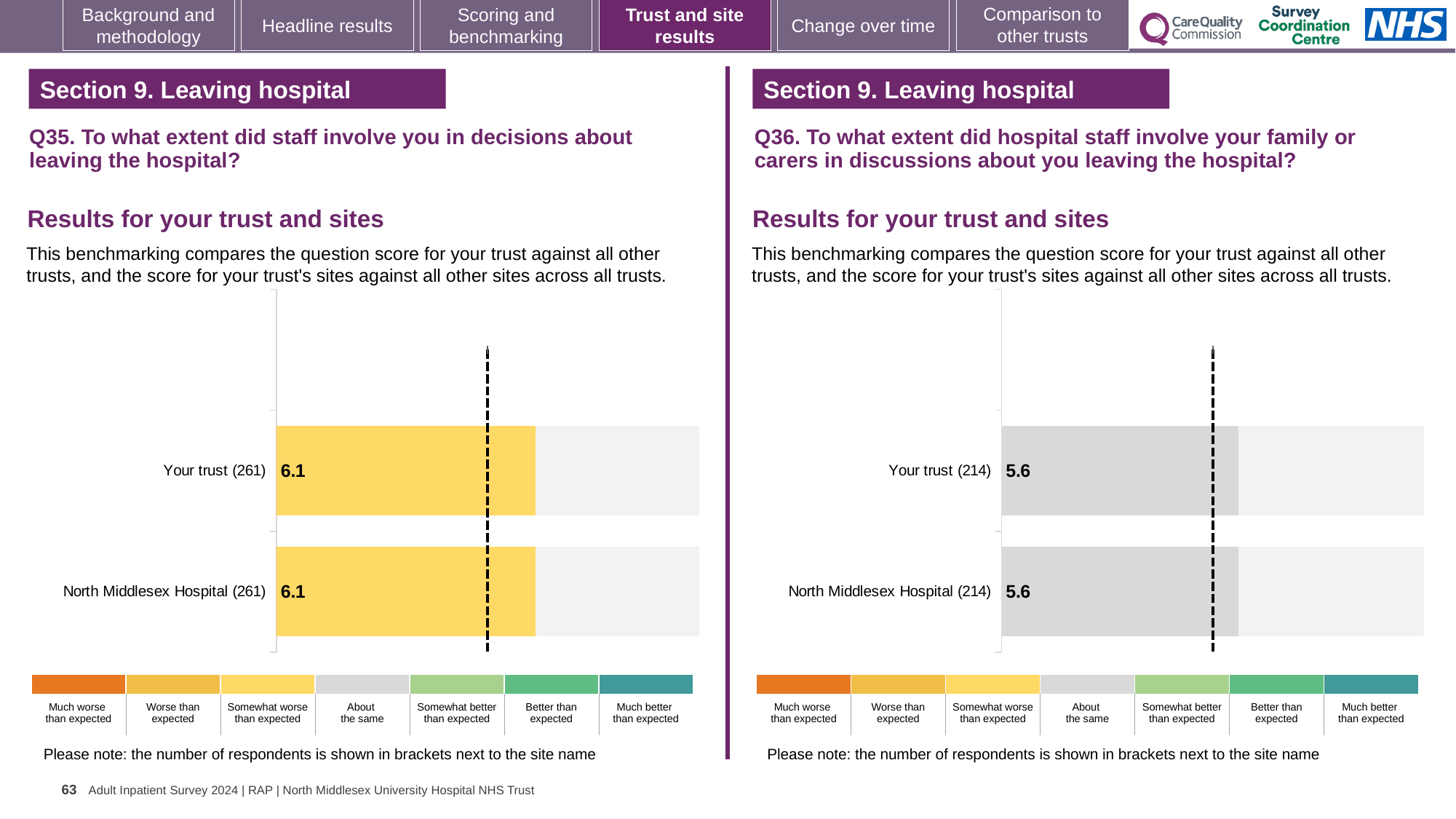
What kind of chart is used for the Q35 results on the left? Bar chart How many bars are plotted in the Q36 chart on the right? 2 In the Q36 chart on the right, what is the score for Your trust? 5.6 According to the colour key, which benchmark category do the grey bars in the Q36 chart on the right represent? About the same In the Q35 chart on the left, how many respondents are shown in brackets next to Your trust? 261 How many bars are plotted in the Q35 chart on the left? 2 In the Q35 chart on the left, what is the difference between the Your trust score and the North Middlesex Hospital score? 0 In the Q35 chart on the left, what is the score for North Middlesex Hospital? 6.1 In the Q36 chart on the right, what is the score for North Middlesex Hospital? 5.6 In the Q36 chart on the right, how many respondents are shown in brackets next to North Middlesex Hospital? 214 In the Q35 chart on the left, what is the score for Your trust? 6.1 In the Q36 chart on the right, what is the difference between the Your trust score and the North Middlesex Hospital score? 0